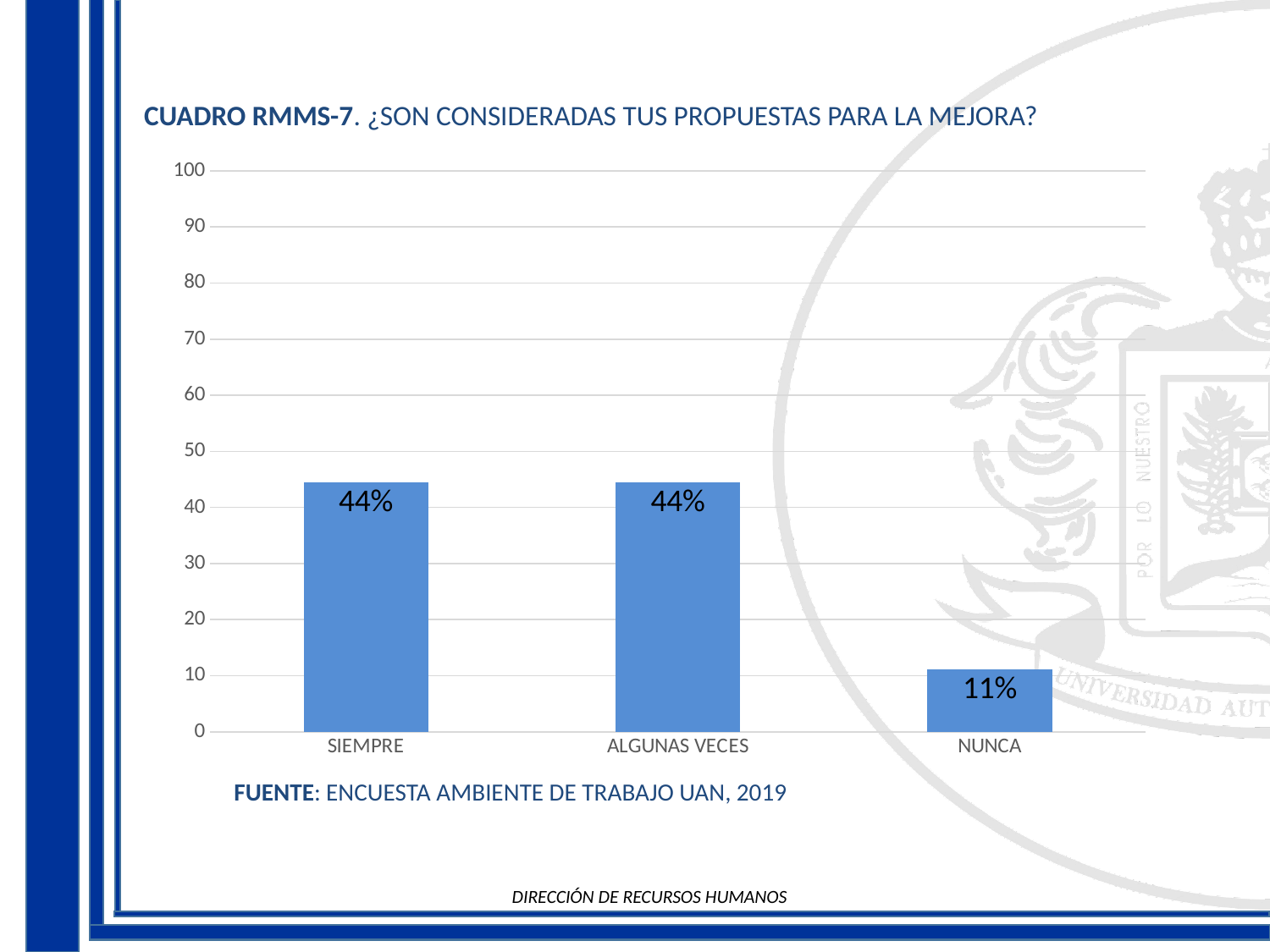
What source is cited below the chart? ENCUESTA AMBIENTE DE TRABAJO UAN, 2019 What is the difference between the values for SIEMPRE and NUNCA? 33% Which is larger, the value for ALGUNAS VECES or the value for NUNCA? ALGUNAS VECES What is the value for ALGUNAS VECES? 44% Is the value for SIEMPRE greater or less than 40? greater Which category has the lowest value? NUNCA What is the title of the chart? CUADRO RMMS-7. ¿SON CONSIDERADAS TUS PROPUESTAS PARA LA MEJORA? How many categories are shown on the x axis? 3 What is the value for SIEMPRE? 44% What kind of chart is shown on the slide? bar chart What is the value for NUNCA? 11% Is the value for NUNCA greater or less than 20? less